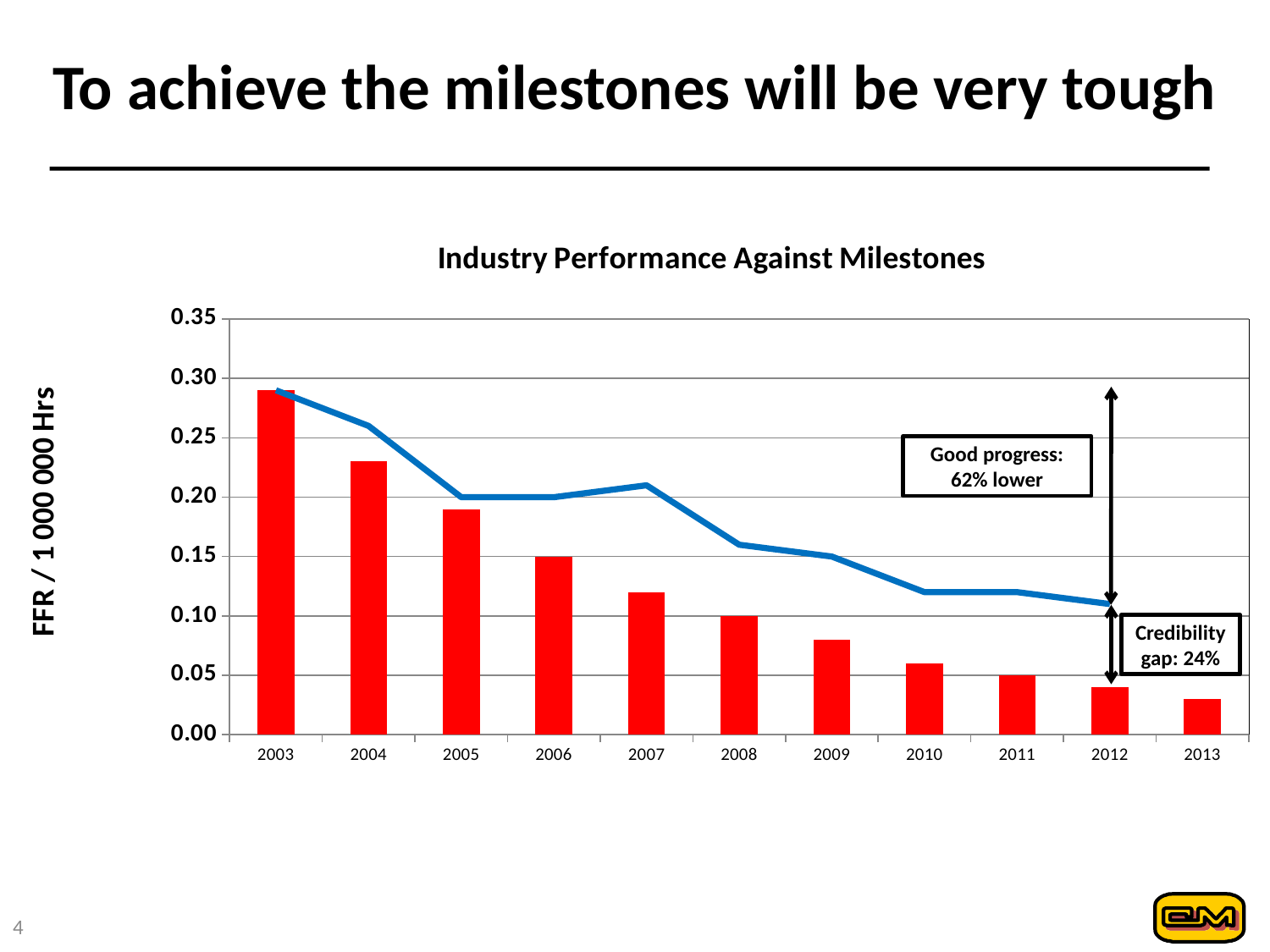
Is the blue line value for 2012 greater or less than 0.10? greater How many years are shown on the x axis of the chart? 11 Do the red bars rise or fall from 2003 to 2013? Fall Is the red bar for 2013 greater or less than 0.05? less What kind of chart is shown on the slide? A bar chart with a line overlaid Which year has the lowest red bar? 2013 Which year has the larger red bar, 2004 or 2005? 2004 Is the red bar for 2007 greater or less than 0.10? greater What is the label on the vertical axis of the chart? FFR / 1 000 000 Hrs What is the title of the chart? Industry Performance Against Milestones Which year has the highest red bar? 2003